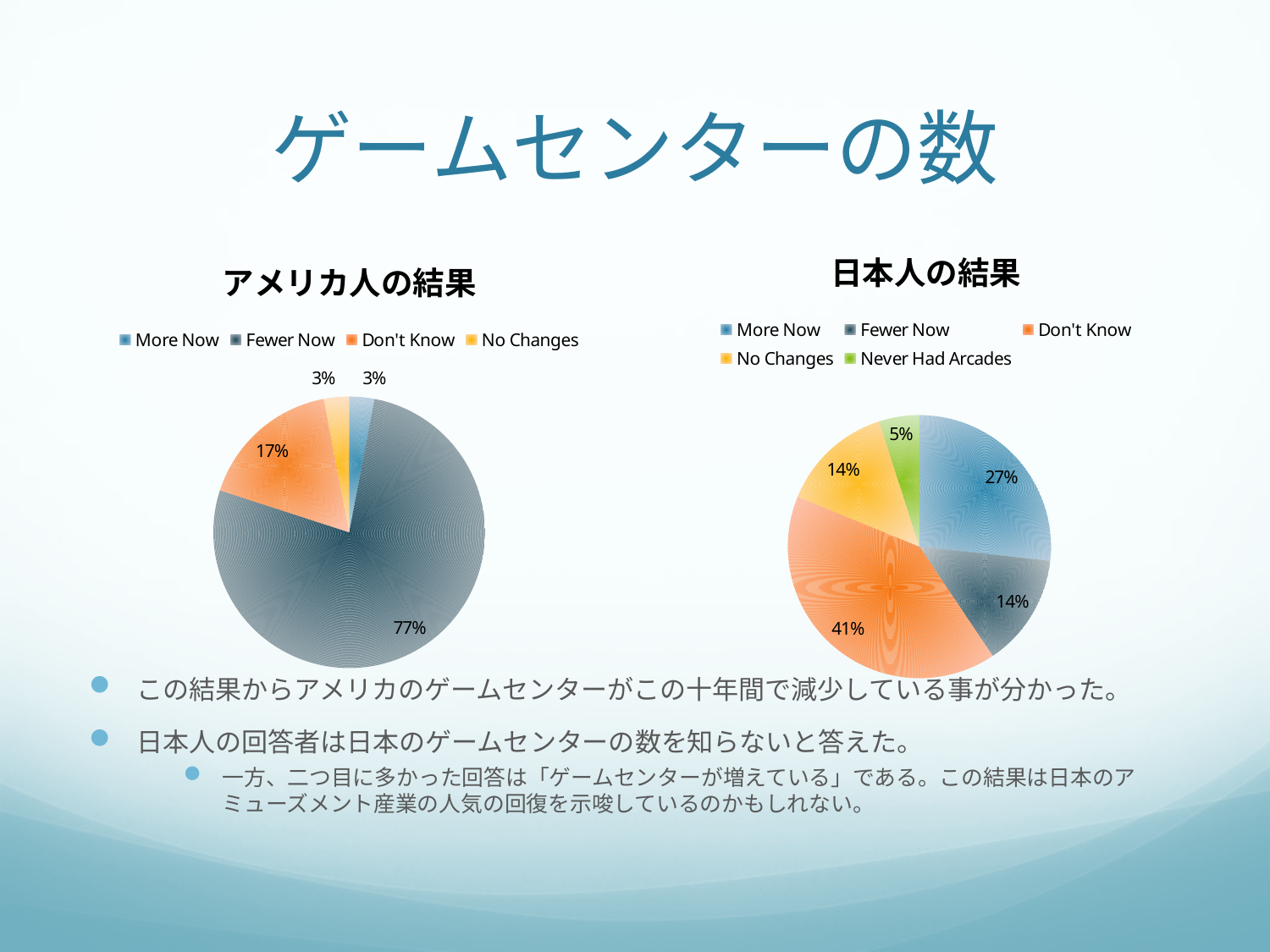
In the 日本人の結果 chart, what share of respondents answered More Now? 27% In the アメリカ人の結果 chart, how many categories does the legend list? 4 In the 日本人の結果 chart, what share of respondents answered Never Had Arcades? 5% What type of chart is used for the アメリカ人の結果 data? Pie chart In the アメリカ人の結果 chart, which response has the largest share? Fewer Now In the アメリカ人の結果 chart, what share of respondents answered More Now? 3% In the 日本人の結果 chart, how many categories does the legend list? 5 In the 日本人の結果 chart, what is the difference between the Don't Know share and the More Now share? 14% In the アメリカ人の結果 chart, what share of respondents answered Don't Know? 17% In the 日本人の結果 chart, which response has the smallest share? Never Had Arcades In the 日本人の結果 chart, what share of respondents answered Don't Know? 41% In the アメリカ人の結果 chart, what share of respondents answered Fewer Now? 77%